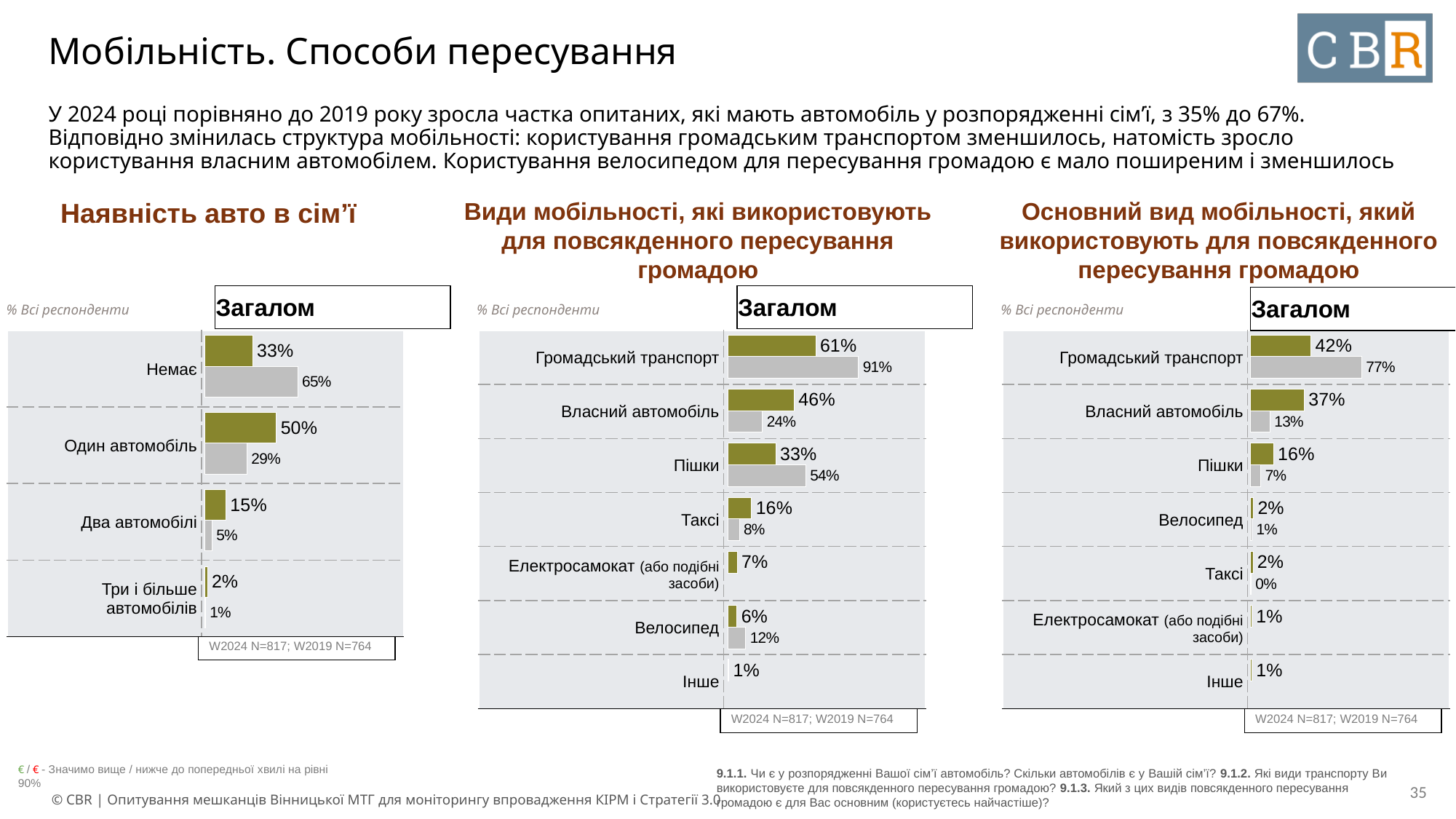
In the chart 'Види мобільності, які використовують для повсякденного пересування громадою', what is the difference between the 2019 (grey) and 2024 (olive) values for 'Громадський транспорт'? 30% In the chart 'Наявність авто в сім’ї', which category has the highest 2024 (olive bar) value? Один автомобіль In the chart 'Основний вид мобільності, який використовують для повсякденного пересування громадою', what is the 2019 (grey bar) value for 'Громадський транспорт'? 77% In the chart 'Основний вид мобільності, який використовують для повсякденного пересування громадою', what is the 2024 (olive bar) value for 'Власний автомобіль'? 37% In the chart 'Наявність авто в сім’ї', how many categories are shown? 4 In the chart 'Наявність авто в сім’ї', what is the 2019 (grey bar) value for 'Немає'? 65% In the chart 'Види мобільності, які використовують для повсякденного пересування громадою', what is the 2024 (olive bar) value for 'Громадський транспорт'? 61% In the chart 'Види мобільності, які використовують для повсякденного пересування громадою', which category has the lowest 2024 (olive bar) value? Інше In the chart 'Основний вид мобільності, який використовують для повсякденного пересування громадою', how many categories are listed? 7 What type of chart is used for 'Наявність авто в сім’ї'? Bar chart In the chart 'Види мобільності, які використовують для повсякденного пересування громадою', which is larger for 'Пішки': the 2024 (olive) value or the 2019 (grey) value? 2019 (grey), 54% In the chart 'Наявність авто в сім’ї', what is the 2024 (olive bar) value for 'Один автомобіль'? 50%